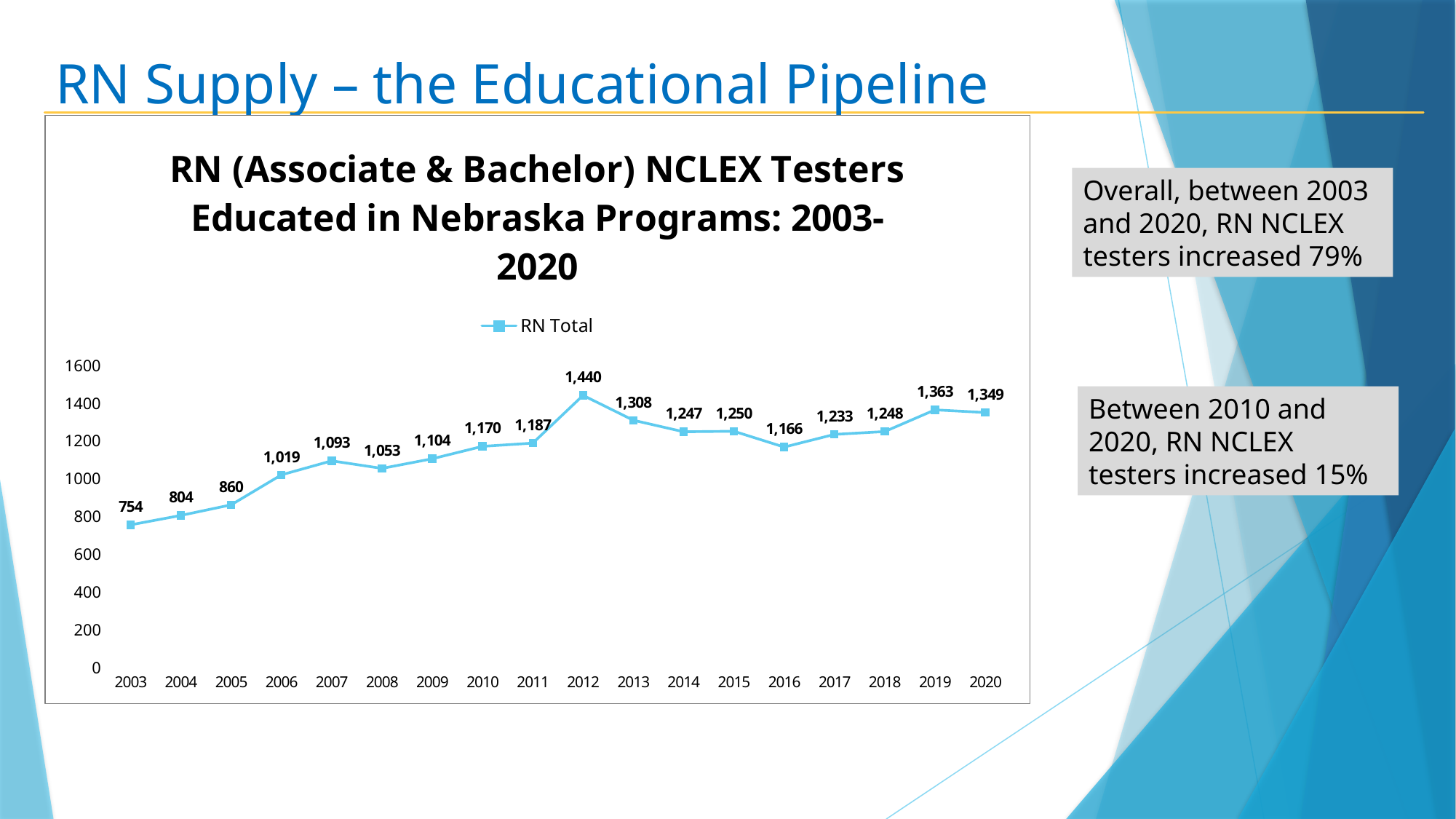
Which year has the highest RN Total value? 2012 What is the RN Total value for 2003? 754 What is the name of the series shown in the legend? RN Total What kind of chart is shown on the slide? line chart Which year has the lowest RN Total value? 2003 How many years are plotted on the x axis? 18 What is the RN Total value for 2012? 1,440 Which year has a larger RN Total value, 2019 or 2020? 2019 What is the difference between the RN Total values for 2012 and 2013? 132 What is the RN Total value for 2016? 1,166 What is the difference between the RN Total values for 2020 and 2003? 595 Is the RN Total value for 2007 greater or less than 1000? greater